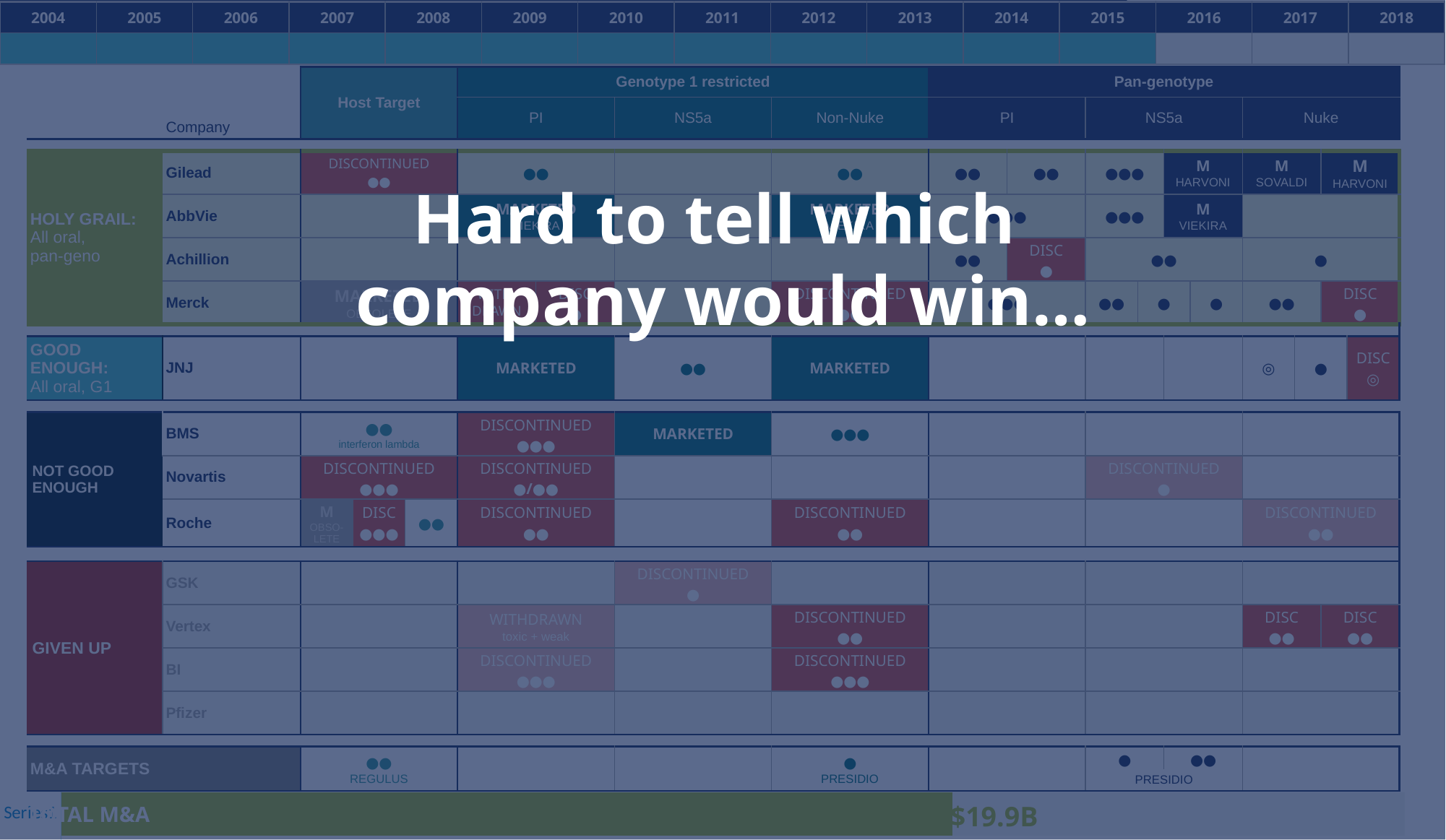
What series name is shown at the left of the TOTAL M&A bar at the bottom of the slide? Series1 How many bars does the TOTAL M&A chart at the bottom of the slide show? 1 What colour is the TOTAL M&A bar at the bottom of the slide? green What value is printed on the TOTAL M&A bar at the bottom of the slide? $19.9B What kind of chart is the TOTAL M&A element at the bottom of the slide? bar chart